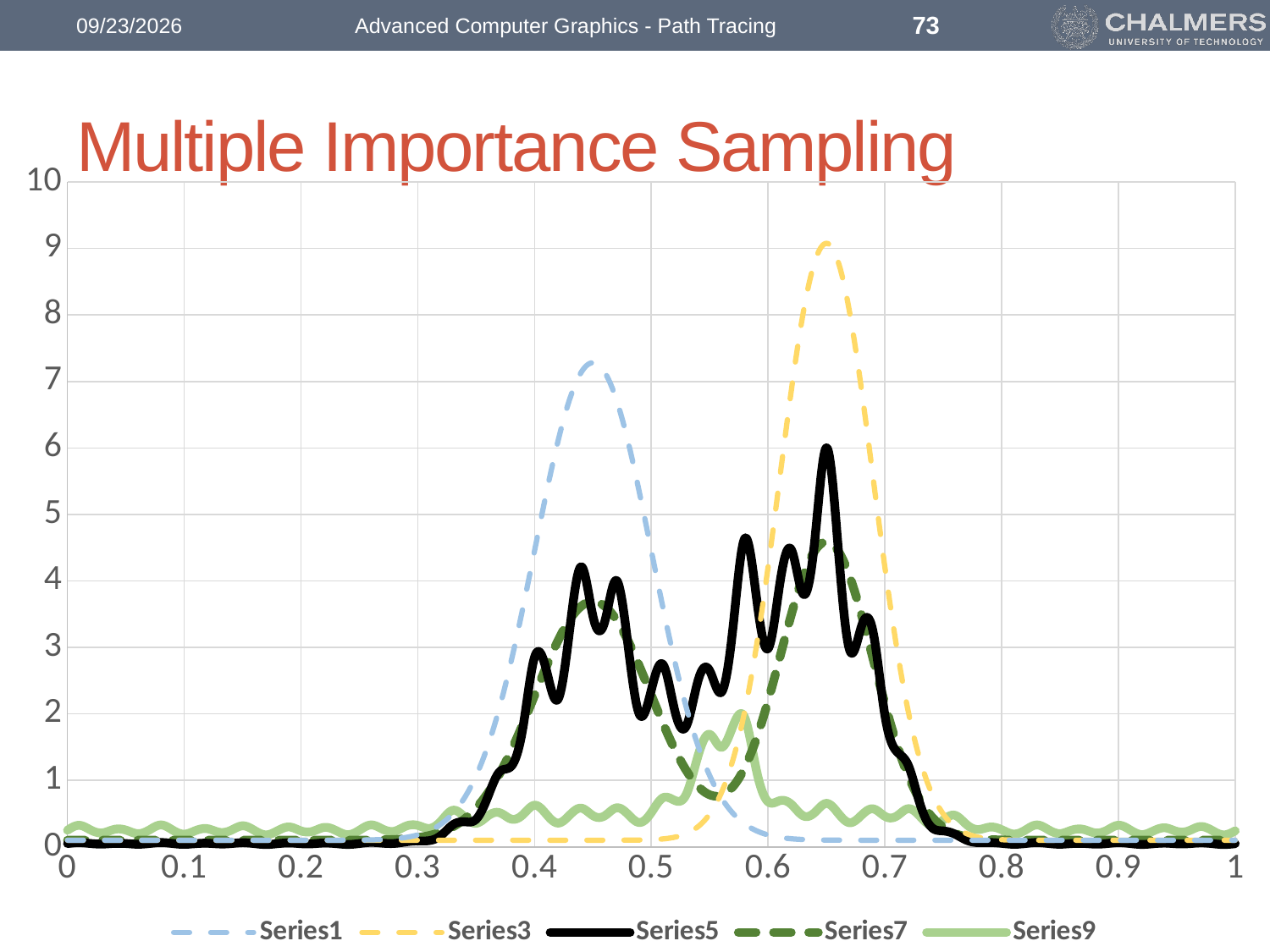
Which series has the lowest peak value on the chart? Series9 What kind of chart is shown on the slide? line chart Is the peak value of Series3 greater or less than 8? greater Is the peak value of Series1 greater or less than 6? greater What is the maximum value shown on the y axis? 10 How many series does the legend list? 5 Does Series3 rise or fall as x goes from 0.7 to 0.8? fall Which has a higher peak, Series1 or Series5? Series1 Is the peak value of Series5 greater or less than 7? less Which series is drawn as a solid black line? Series5 Which series reaches the highest peak on the chart? Series3 What is the title of the chart? Multiple Importance Sampling